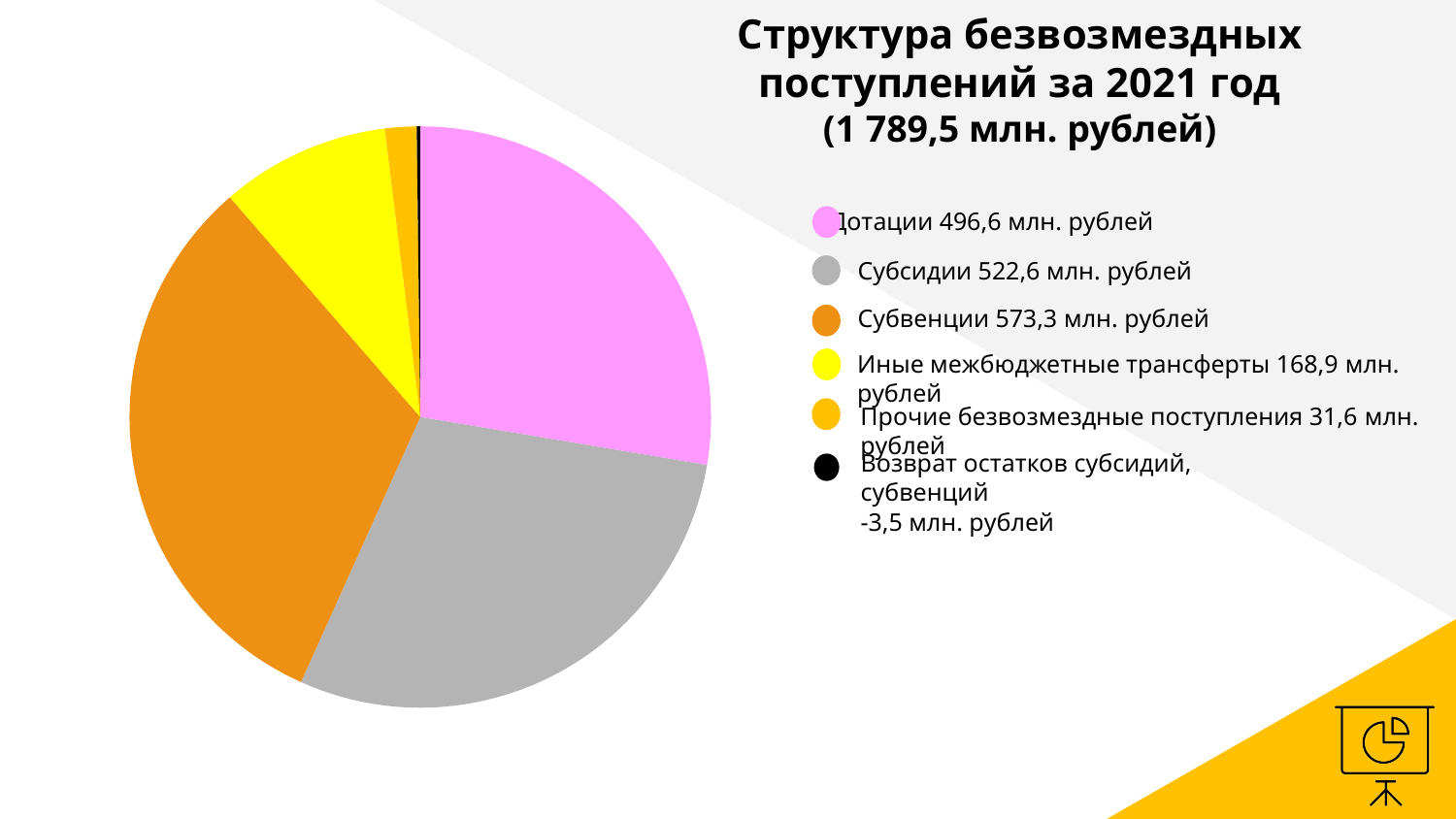
How many categories does the pie chart have? 6 What is the value for Прочие безвозмездные поступления? 31,6 млн. рублей Which category has the lowest value? Возврат остатков субсидий, субвенций What is the difference between Субвенции and Субсидии? 50,7 млн. рублей What total amount is given in the chart title? 1 789,5 млн. рублей Which is larger, Субсидии or Дотации? Субсидии Which category has the highest value? Субвенции What is the value for Дотации? 496,6 млн. рублей What is the value for Субвенции? 573,3 млн. рублей What is the value for Возврат остатков субсидий, субвенций? -3,5 млн. рублей What is the value for Иные межбюджетные трансферты? 168,9 млн. рублей What type of chart is shown on the slide? Pie chart